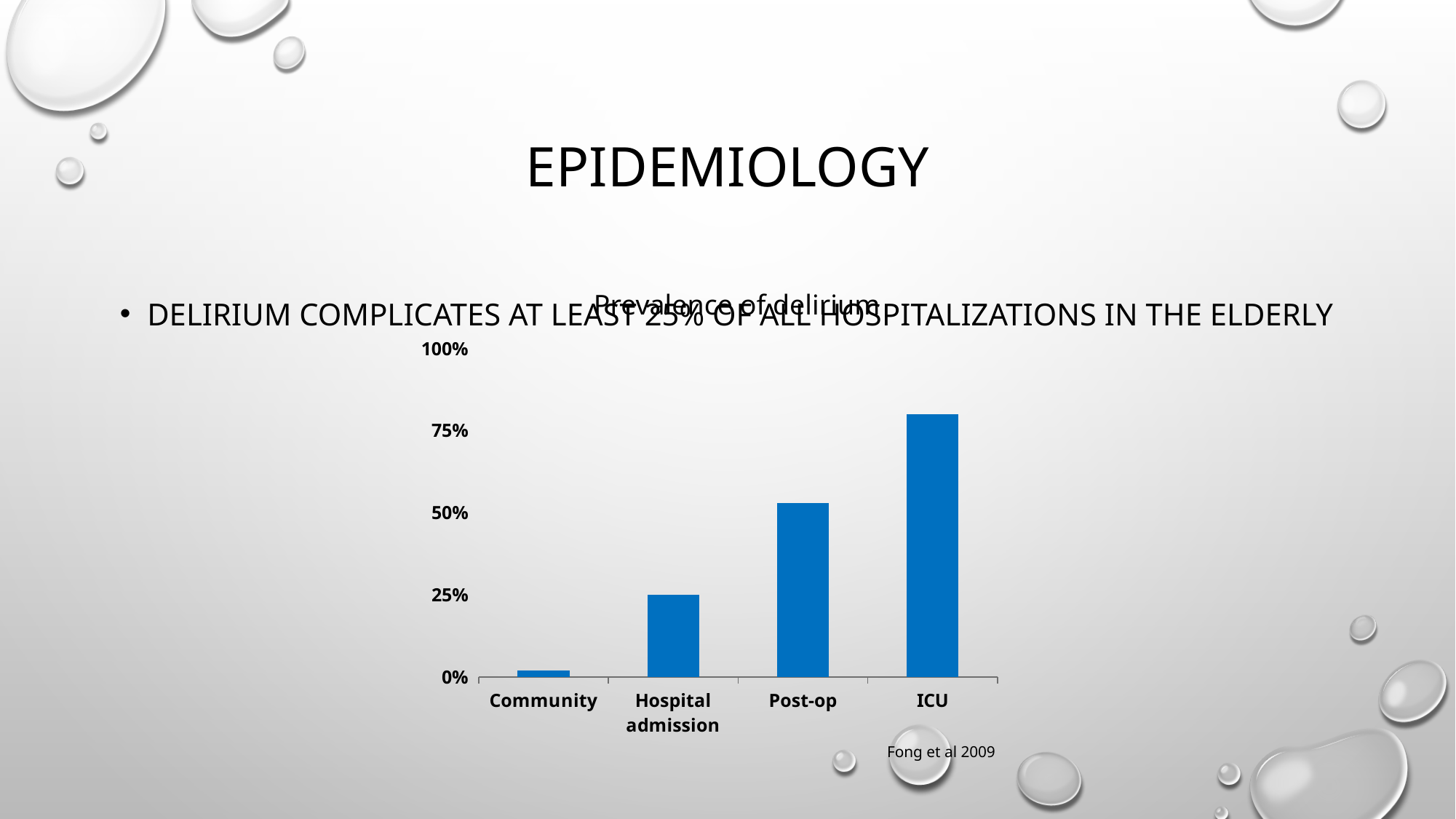
How many categories are shown on the x axis of the chart? 4 What is the title of the chart? Prevalence of delirium Is the value for Post-op greater or less than 50%? greater Is the value for Community greater or less than 25%? less Which is larger, the value for Post-op or the value for Hospital admission? Post-op What kind of chart is shown on the slide? bar chart Is the value for ICU greater or less than 75%? greater What is the prevalence of delirium for Hospital admission? 25% Do the values rise or fall moving from Community to ICU along the x axis? rise Which category has the highest prevalence of delirium? ICU What source is cited below the chart? Fong et al 2009 Which category has the lowest prevalence of delirium? Community